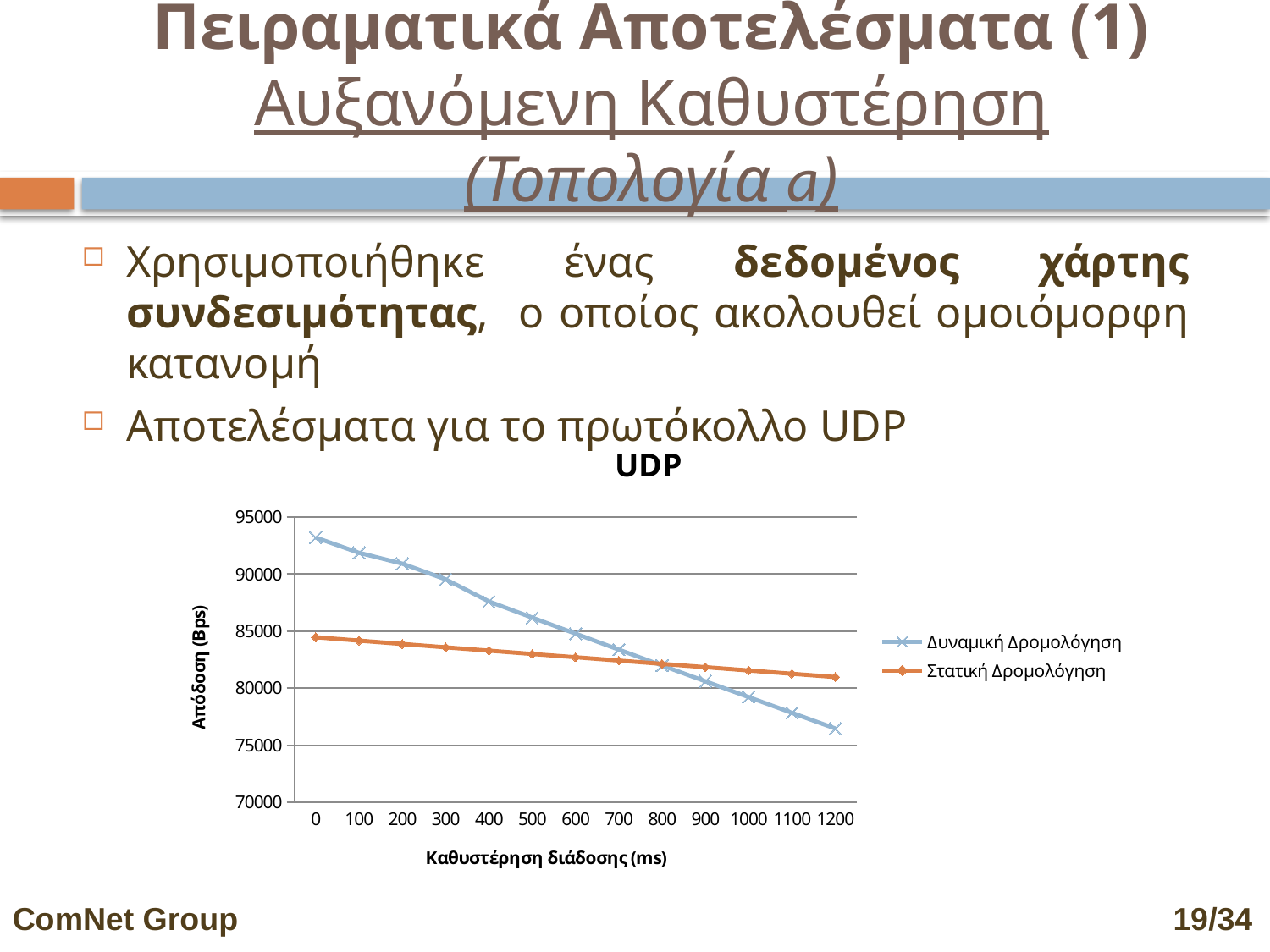
In the UDP chart, which series has the higher value at 0 ms, Δυναμική Δρομολόγηση or Στατική Δρομολόγηση? Δυναμική Δρομολόγηση How many data points are plotted along the x axis for each series in the UDP chart? 13 In the UDP chart, does the Στατική Δρομολόγηση series rise or fall along the x axis? fall In the UDP chart, is the value for Δυναμική Δρομολόγηση at 0 ms greater or less than 90000? greater In the UDP chart, does the Δυναμική Δρομολόγηση series rise or fall as the propagation delay increases? fall In the UDP chart, is the value for Στατική Δρομολόγηση at 1200 ms greater or less than 80000? greater In the UDP chart, is the value for Δυναμική Δρομολόγηση at 1200 ms greater or less than 80000? less What is the label of the y axis of the UDP chart? Απόδοση (Bps) What kind of chart is shown on the slide? line chart How many series does the legend of the UDP chart list? 2 In the UDP chart, which series has the higher value at 1200 ms, Δυναμική Δρομολόγηση or Στατική Δρομολόγηση? Στατική Δρομολόγηση